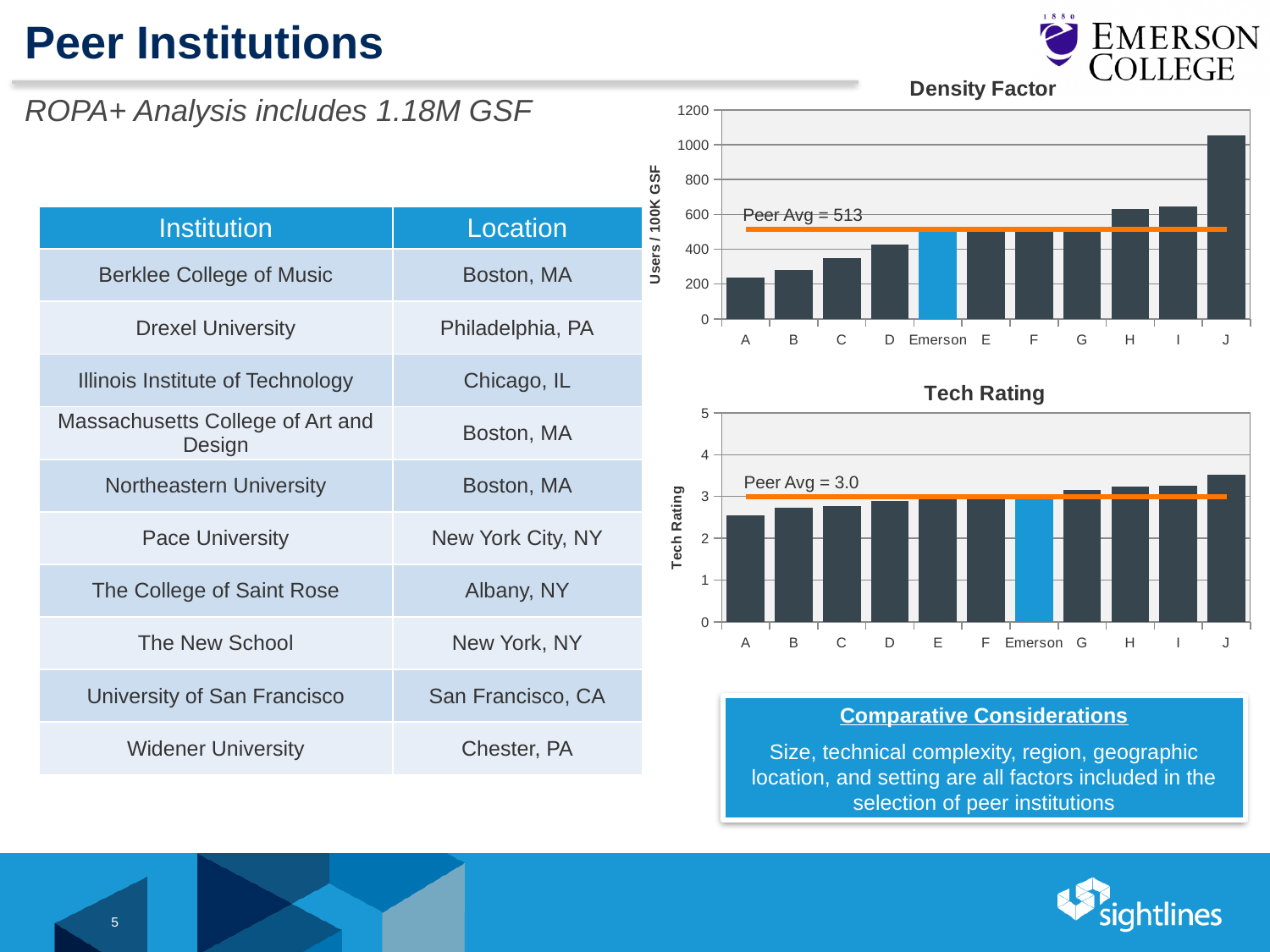
In the Tech Rating chart, which institution has the lowest rating? A In the Density Factor chart, which institution has the lowest value? A In the Density Factor chart, which institution has the highest value? J In the Tech Rating chart, what is the peer average shown? 3.0 In the Density Factor chart, what is the peer average shown? 513 In the Density Factor chart, which is larger, the value for J or the value for Emerson? J In the Density Factor chart, is the value for J greater or less than 800? greater What kind of chart is the Density Factor chart? Bar chart In the Tech Rating chart, which institution has the highest rating? J How many institutions are plotted in the Tech Rating chart? 11 In the Density Factor chart, is the value for A greater or less than 400? less In the Tech Rating chart, is the value for A greater or less than 3? less